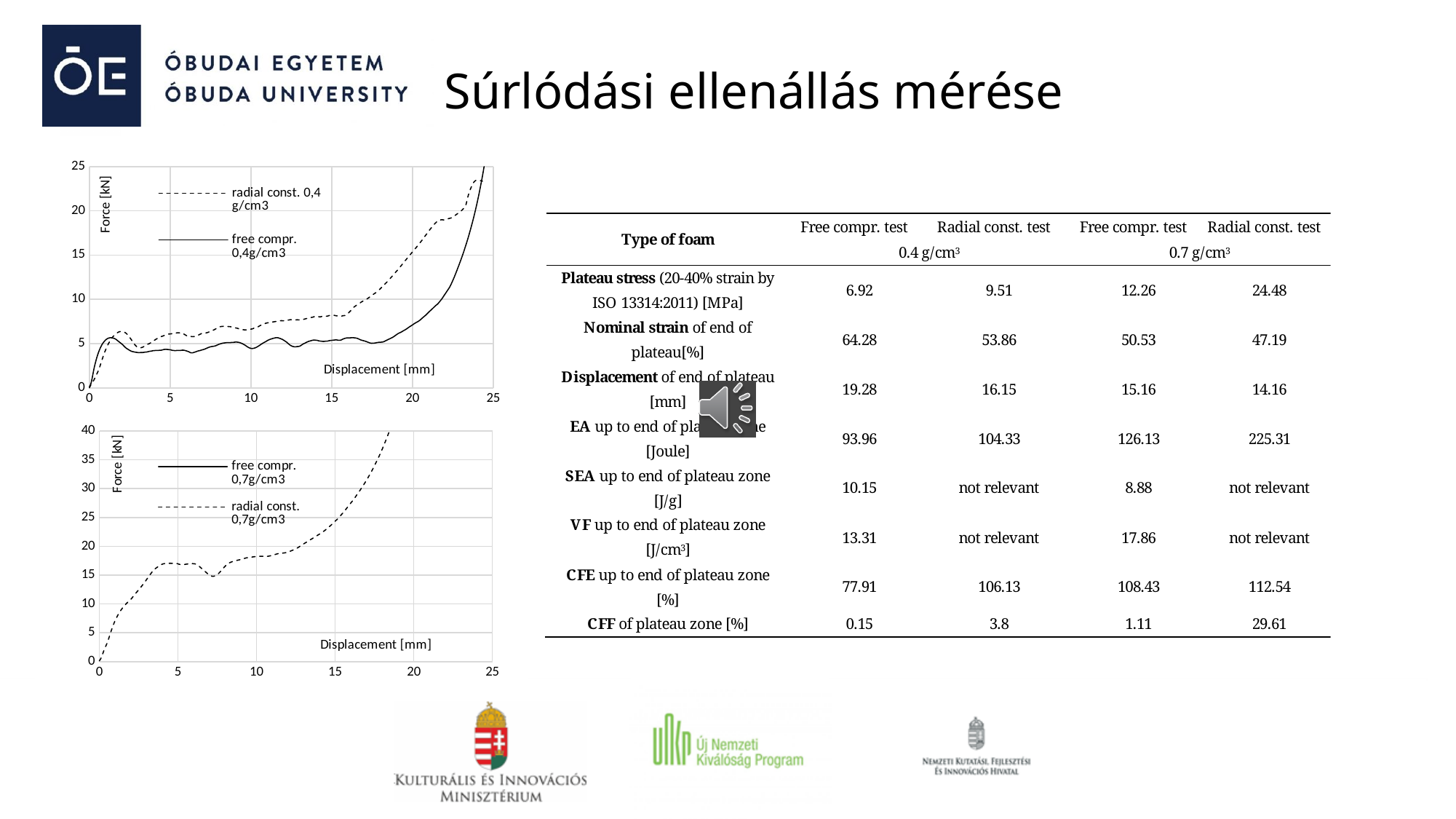
How many series does the legend of the top chart list? 2 In the top chart, at a displacement of 20 mm, which series shows the higher force: 'radial const. 0,4 g/cm3' or 'free compr. 0,4g/cm3'? radial const. 0,4 g/cm3 What kind of chart is the top chart on the left of the slide? line chart In the top chart, is the force for 'radial const. 0,4 g/cm3' at a displacement of 20 mm greater or less than 10 kN? greater In the top chart, does the force for 'free compr. 0,4g/cm3' overall rise or fall as displacement increases from 0 to 25 mm? rise In the top chart, is the force for 'free compr. 0,4g/cm3' at a displacement of 20 mm greater or less than 10 kN? less In the bottom chart, is the force for 'radial const. 0,7g/cm3' at a displacement of 15 mm greater or less than 20 kN? greater What is the label of the vertical axis of the top chart? Force [kN] What is the label of the horizontal axis of the bottom chart? Displacement [mm] How many series does the legend of the bottom chart list? 2